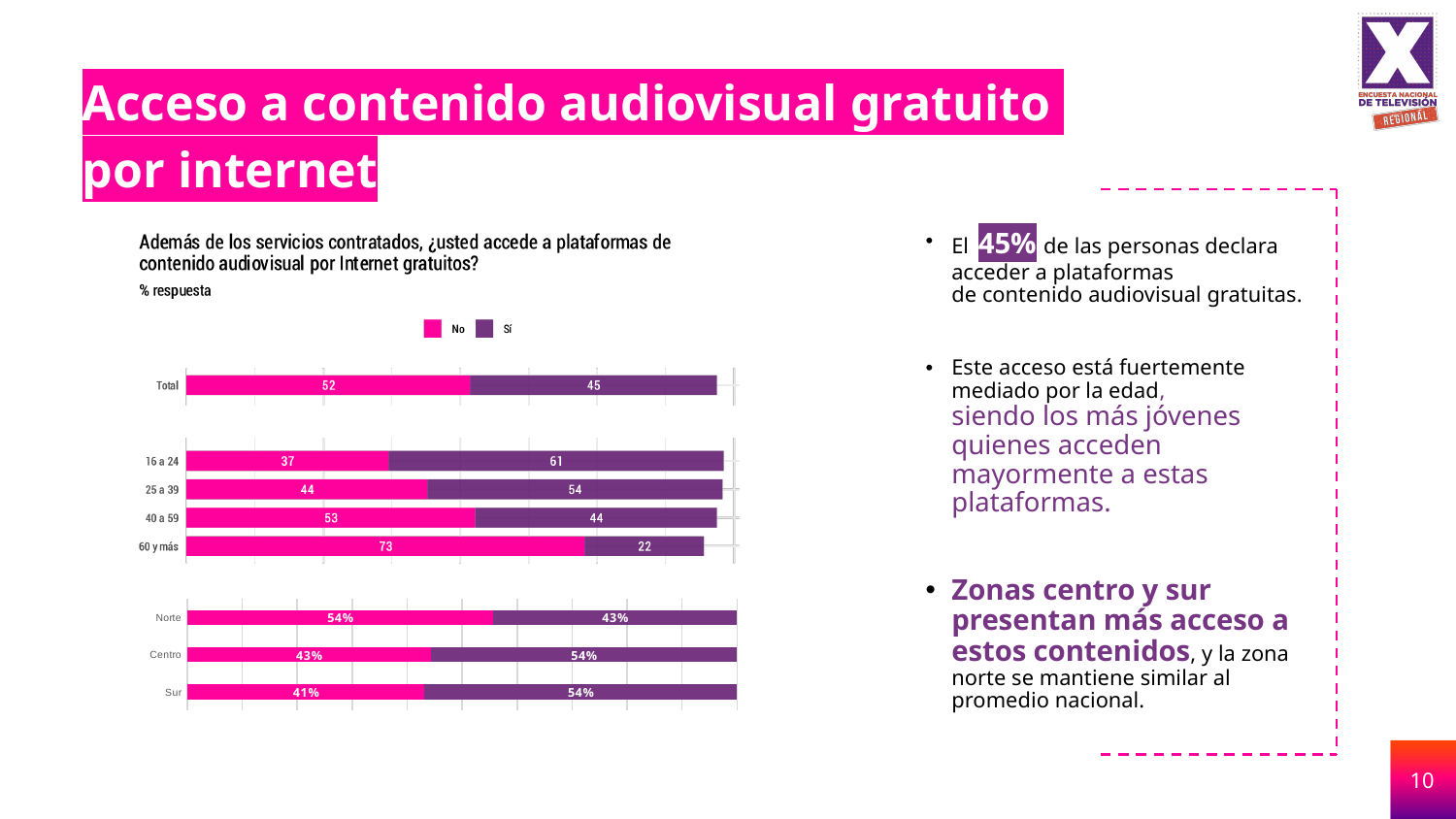
What is the 'No' value for the Sur region? 41% What is the 'Sí' value for the 16 a 24 age group? 61 How many series does the legend list? 2 What is the difference between the 'Sí' values for 16 a 24 and 60 y más? 39 What is the 'Sí' value for the Total bar? 45 Which age group has the highest 'Sí' value? 16 a 24 What kind of chart is shown on the slide? Stacked bar chart Do the 'Sí' values rise or fall as the age groups go from 16 a 24 to 60 y más? Fall What is the 'No' value for the 60 y más age group? 73 Which age group has the lowest 'Sí' value? 60 y más Which is larger, the 'Sí' value for Norte or the 'Sí' value for Centro? Centro Which colour represents the 'No' series in the chart? Pink